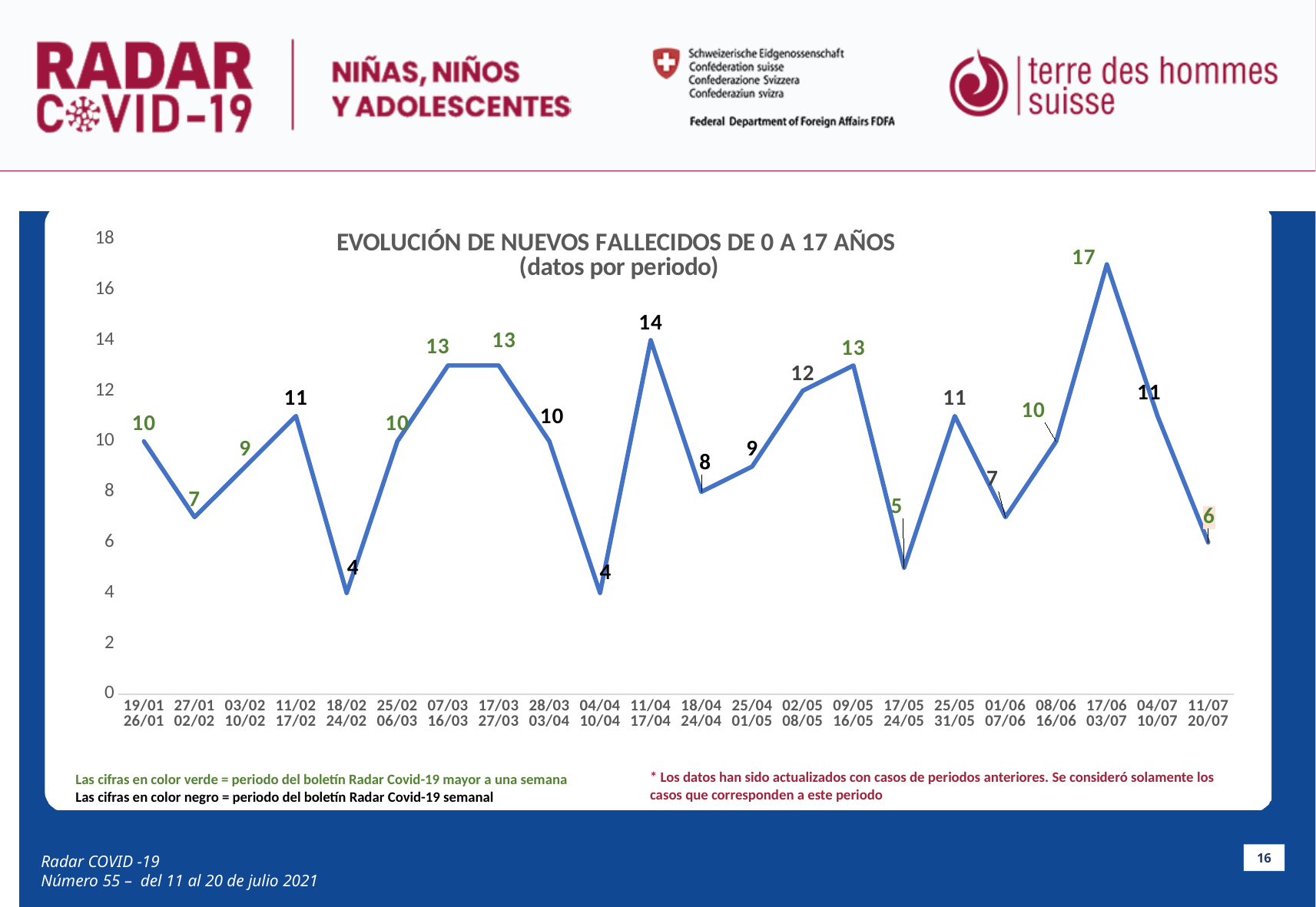
What is the title of the chart? EVOLUCIÓN DE NUEVOS FALLECIDOS DE 0 A 17 AÑOS (datos por periodo) What is the difference between the value for 17/06–03/07 and the value for 04/07–10/07? 6 Is the value for 18/02–24/02 greater or less than 6? less What is the value for the last period, 11/07–20/07? 6 What kind of chart is shown on the slide? line chart Which is larger, the value for 02/05–08/05 or the value for 25/05–31/05? 02/05–08/05 What is the value for the period 11/04–17/04? 14 What is the lowest value plotted on the chart? 4 Which period has the highest value? 17/06–03/07 What is the value for the period 17/05–24/05? 5 How many periods (data points) are plotted on the chart? 22 Do the values rise or fall between the periods 04/04–10/04 and 11/04–17/04? rise